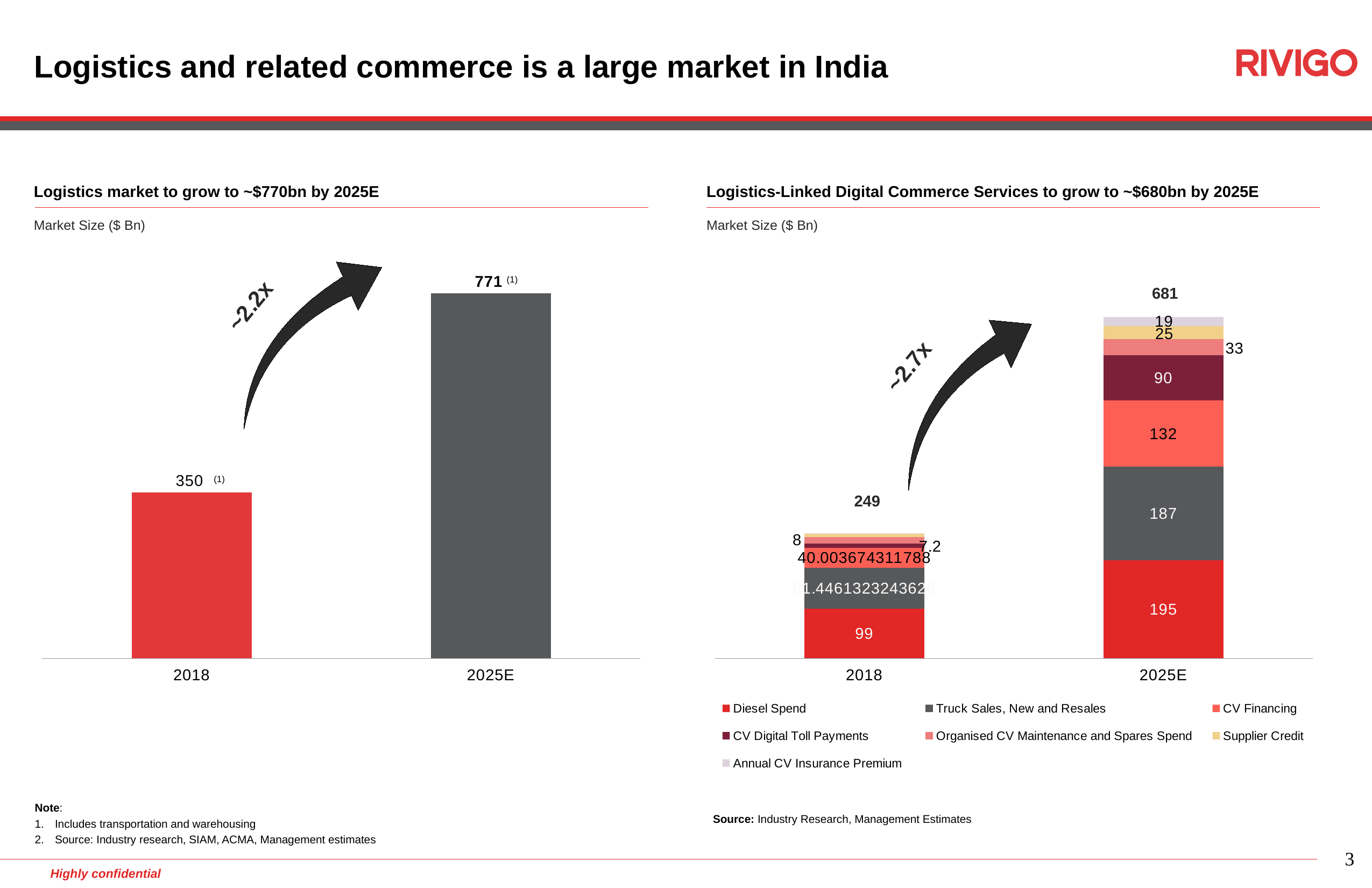
How many categories are shown on the x axis of the left chart (Logistics market to grow to ~$770bn by 2025E)? 2 In the right chart (Logistics-Linked Digital Commerce Services), which is larger for 2025E: CV Financing or CV Digital Toll Payments? CV Financing In the right chart (Logistics-Linked Digital Commerce Services), what is the value of Truck Sales, New and Resales for 2025E? 187 In the left chart (Logistics market to grow to ~$770bn by 2025E), what is the market size for 2025E? 771 What kind of chart is the left chart (Logistics market to grow to ~$770bn by 2025E)? Bar chart In the right chart (Logistics-Linked Digital Commerce Services), what is the value of Diesel Spend for 2018? 99 In the left chart (Logistics market to grow to ~$770bn by 2025E), what is the difference between the 2025E and 2018 values? 421 In the right chart (Logistics-Linked Digital Commerce Services), what is the value of Diesel Spend for 2025E? 195 How many series does the legend of the right chart (Logistics-Linked Digital Commerce Services) list? 7 In the right chart (Logistics-Linked Digital Commerce Services), what is the total of the 2018 stacked bar? 249 In the right chart (Logistics-Linked Digital Commerce Services), what is the total of the 2025E stacked bar? 681 In the left chart (Logistics market to grow to ~$770bn by 2025E), what is the market size for 2018? 350